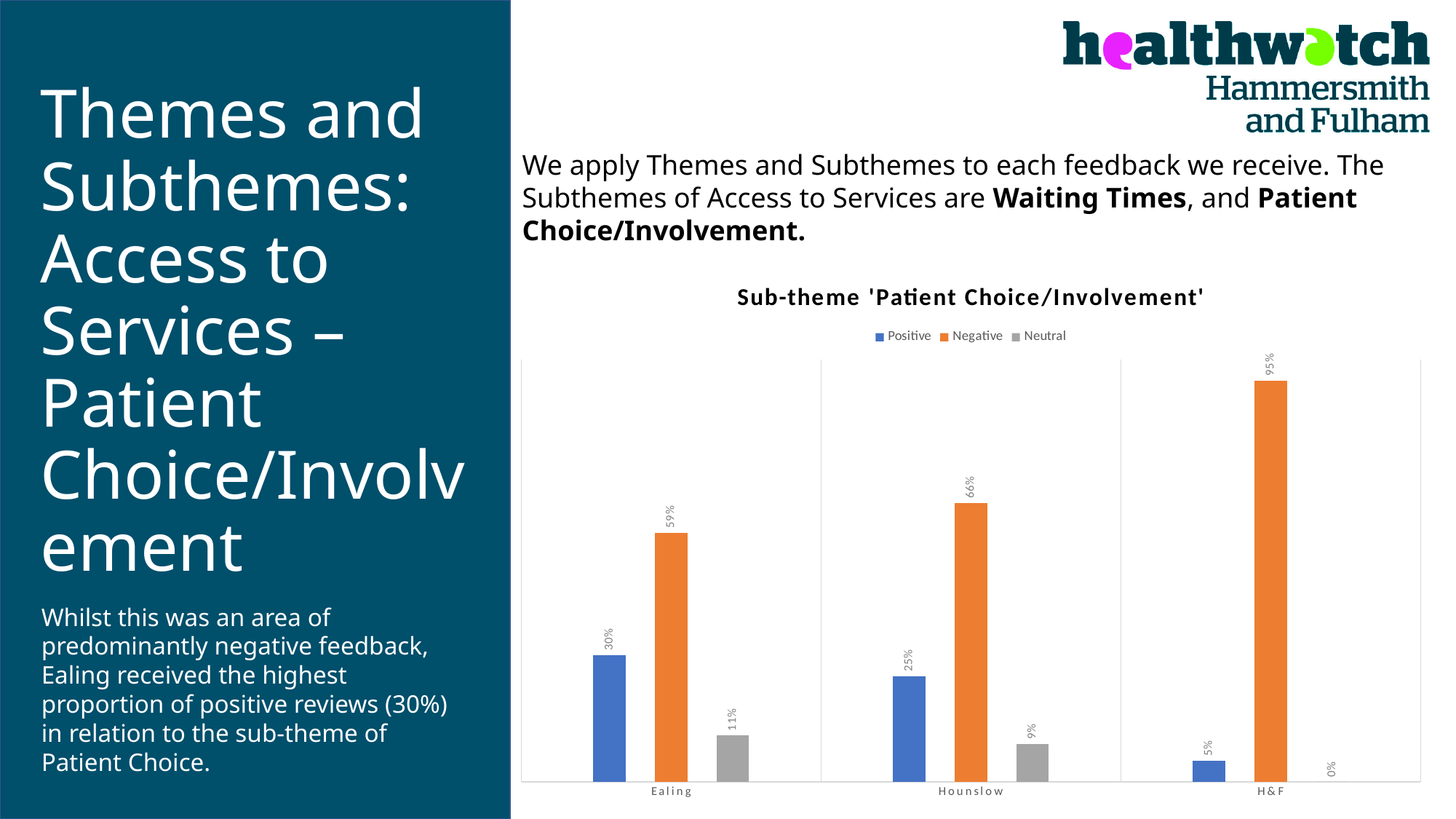
What is the title of the chart? Sub-theme 'Patient Choice/Involvement' What is the difference between the Negative values for Hounslow and Ealing? 7% Which category has the highest Negative value? H&F What is the Positive value for Ealing? 30% Which category has the lowest Positive value? H&F What is the Neutral value for Hounslow? 9% How many series does the legend list? 3 What colour represents the Negative series in the chart? Orange What is the Negative value for H&F? 95% Which is larger, the Positive value for Ealing or the Positive value for Hounslow? Ealing What kind of chart is shown? Bar chart How many categories are shown on the x axis? 3